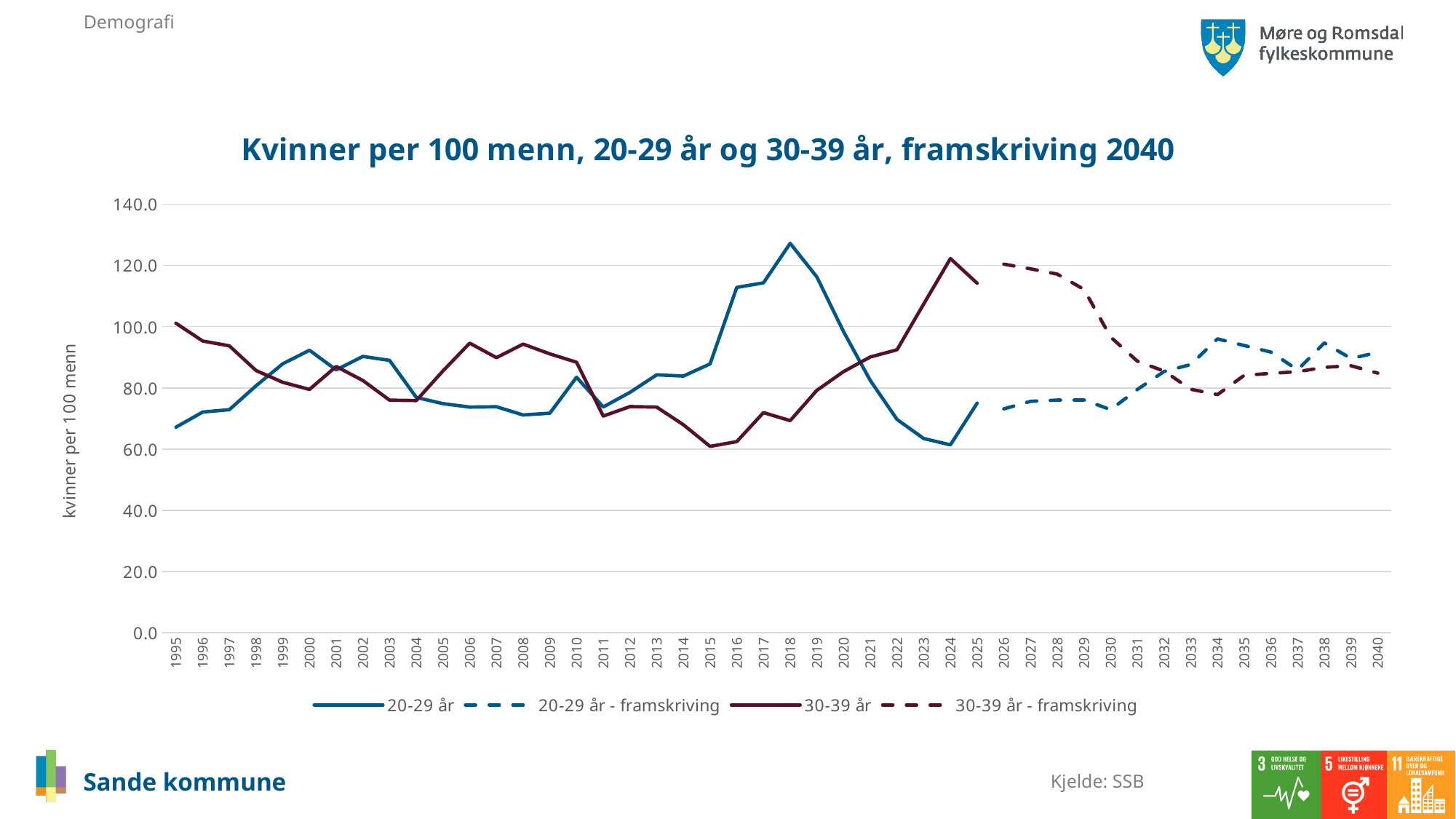
Is the value for 30-39 år - framskriving in 2040 greater or less than 100? less What is the title of the chart? Kvinner per 100 menn, 20-29 år og 30-39 år, framskriving 2040 How many years are labelled along the x axis? 46 In which year does the 20-29 år series reach its highest value? 2018 Is the value for 20-29 år in 1995 greater or less than 80? less In 2024, which series has the larger value, 20-29 år or 30-39 år? 30-39 år Does the 20-29 år series rise or fall between 2018 and 2024? fall Is the value for 20-29 år in 2018 greater or less than 120? greater How many series does the legend list? 4 In which year does the 30-39 år series reach its highest value? 2024 What kind of chart is shown on the slide? line chart